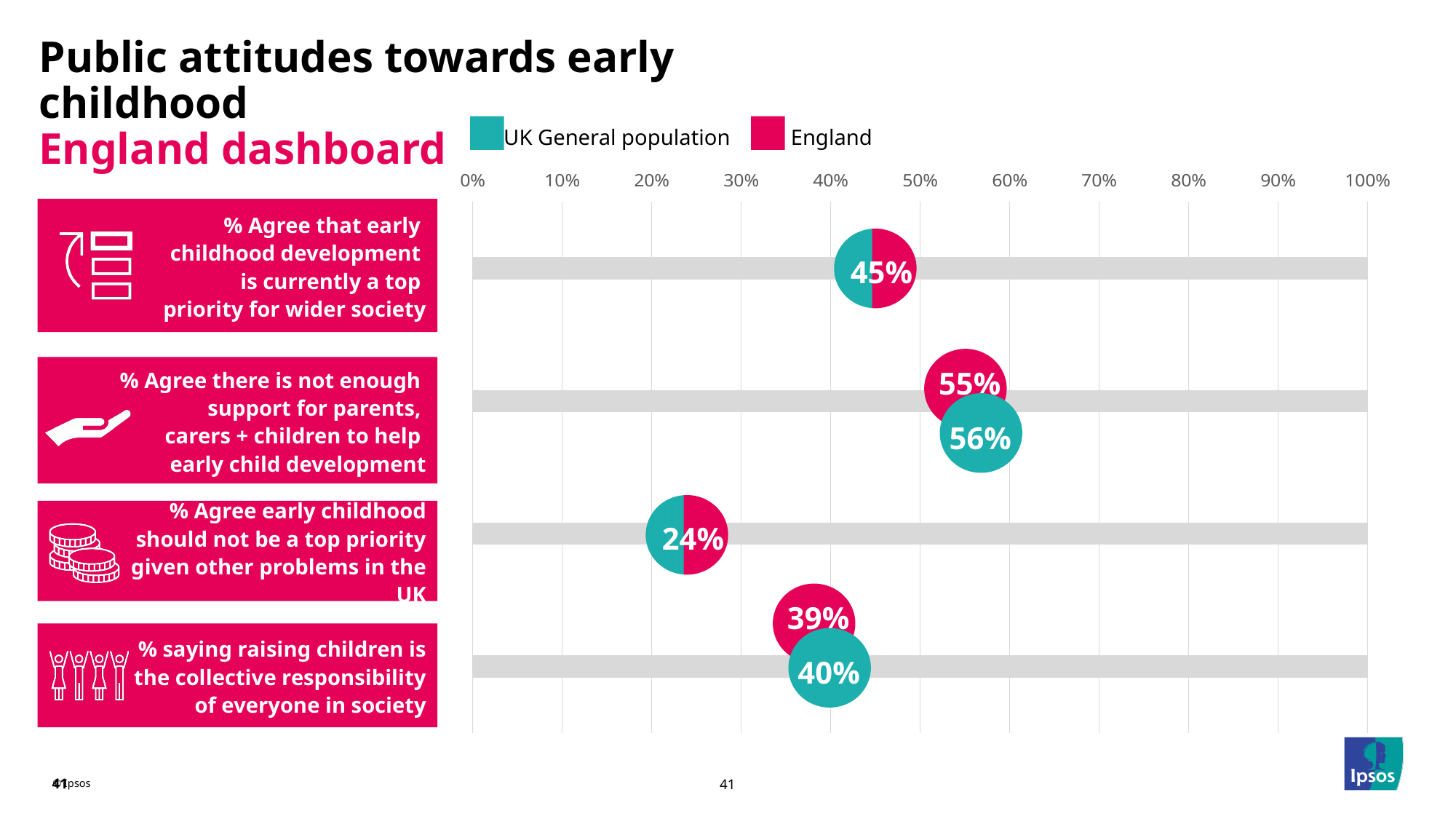
What percentage agree early childhood should not be a top priority given other problems in the UK? 24% How many statements are plotted on the chart? 4 What is the UK General population value for agreeing there is not enough support for parents, carers and children to help early child development? 56% What is the difference between the UK General population and England values for saying raising children is the collective responsibility of everyone in society? 1% What percentage of people in England agree that early childhood development is currently a top priority for wider society? 45% Which colour represents England in the legend? Pink What is the England value for agreeing there is not enough support for parents, carers and children to help early child development? 55% What is the England value for saying raising children is the collective responsibility of everyone in society? 39% Which statement has the lowest percentage agreeing? % Agree early childhood should not be a top priority given other problems in the UK How many series does the legend list? 2 Which statement has the highest percentage for the UK General population? % Agree there is not enough support for parents, carers + children to help early child development What is the UK General population value for saying raising children is the collective responsibility of everyone in society? 40%